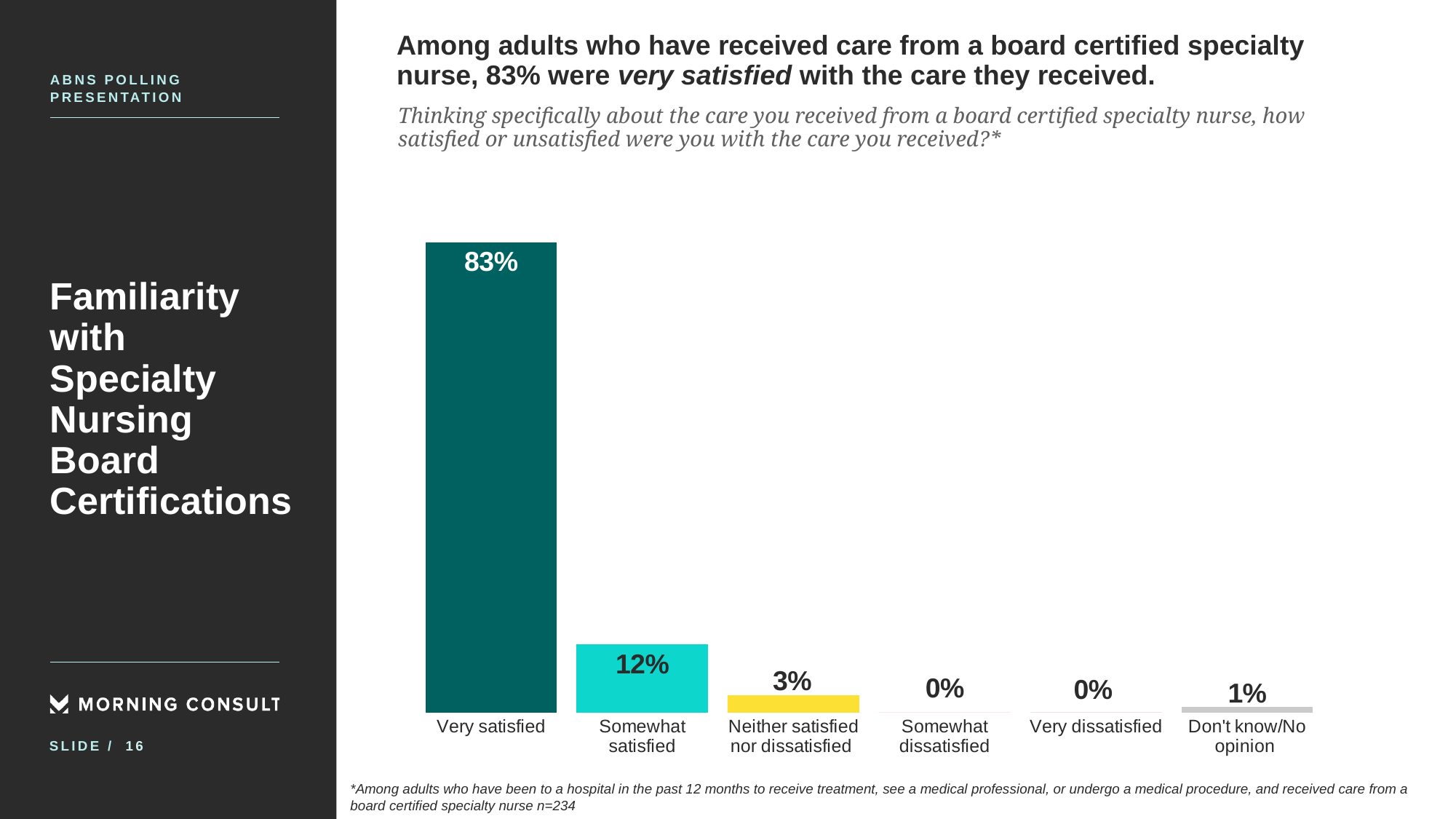
What percentage of respondents were very satisfied with the care they received? 83% Which category has the highest value? Very satisfied What value is shown for 'Very dissatisfied'? 0% What kind of chart is shown on the slide? Bar chart What is the difference between the 'Very satisfied' and 'Somewhat satisfied' values? 71 percentage points Which is larger, the value for 'Somewhat satisfied' or the value for 'Neither satisfied nor dissatisfied'? Somewhat satisfied How many categories are shown on the chart? 6 What percentage of respondents were somewhat satisfied? 12% What value is shown for 'Neither satisfied nor dissatisfied'? 3% What value is shown for 'Don't know/No opinion'? 1% What is the sample size (n) given in the footnote for this chart? n=234 Do the values generally rise or fall from 'Very satisfied' to 'Very dissatisfied' along the x axis? Fall